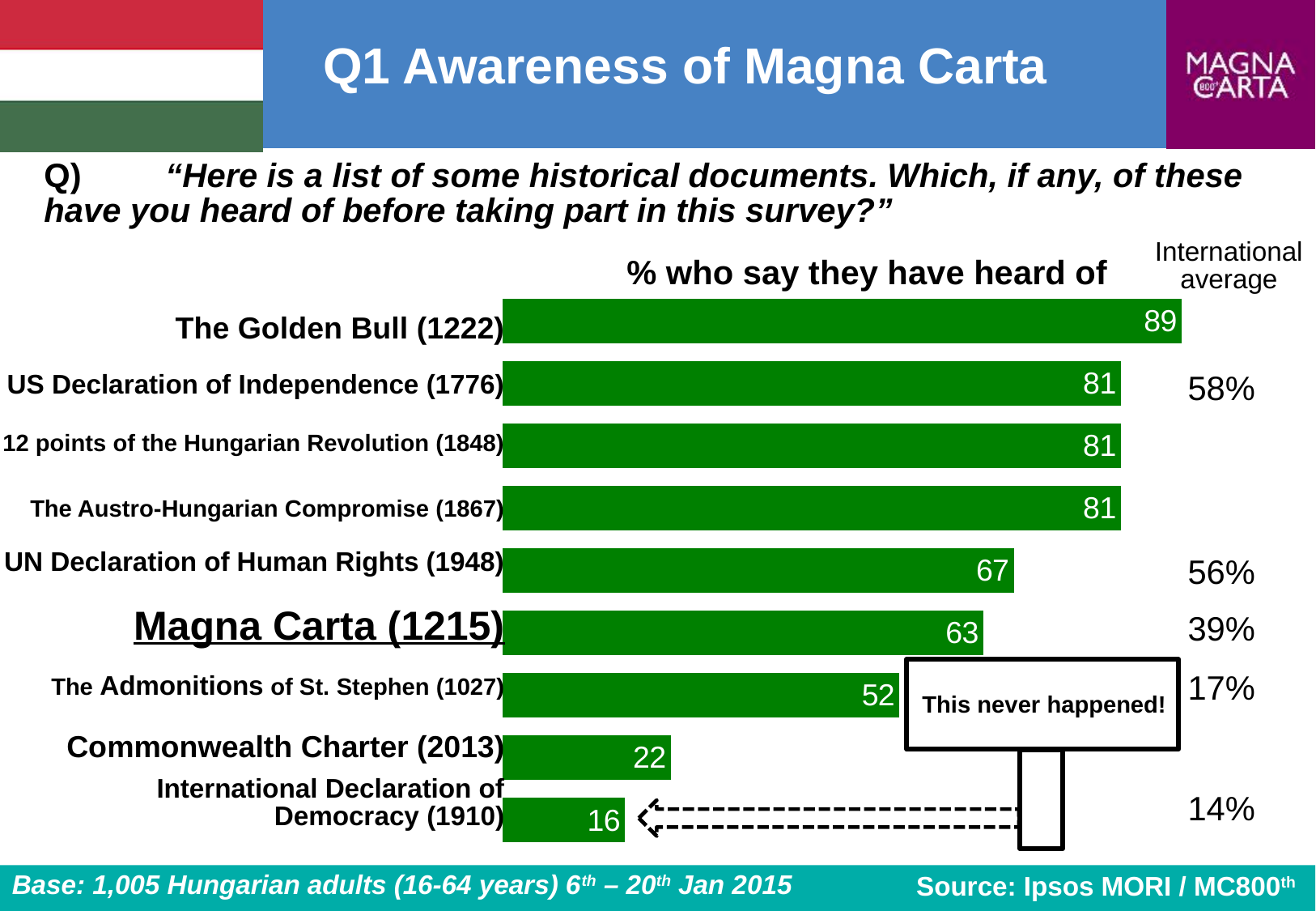
Which historical document has the highest percentage of people who say they have heard of it? The Golden Bull (1222) Which historical document has the lowest percentage of people who say they have heard of it? International Declaration of Democracy (1910) What is the difference between the percentage who have heard of The Golden Bull (1222) and the percentage who have heard of Magna Carta (1215)? 26 How many historical documents are listed in the bar chart? 9 What is the international average shown for Magna Carta (1215)? 39% What percentage say they have heard of the Commonwealth Charter (2013)? 22 What is the difference between the Hungarian percentage for Magna Carta (1215) and its international average? 24 What kind of chart is shown on the slide? Bar chart What percentage say they have heard of Magna Carta (1215)? 63 What does the text in the box pointing to the International Declaration of Democracy (1910) say? This never happened! Which has a higher percentage: UN Declaration of Human Rights (1948) or The Admonitions of St. Stephen (1027)? UN Declaration of Human Rights (1948) What percentage say they have heard of The Golden Bull (1222)? 89